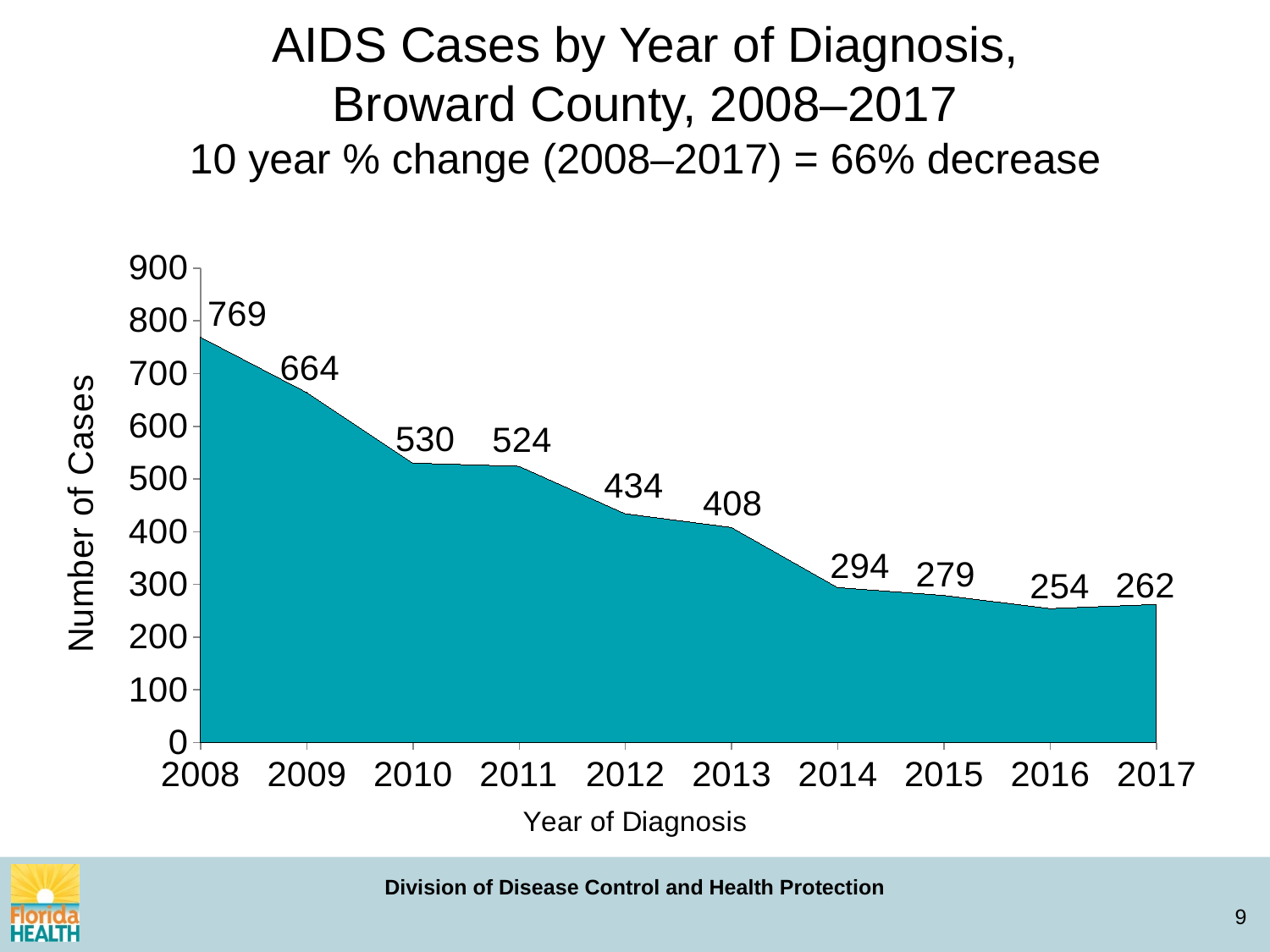
How many years are plotted on the chart? 10 How many AIDS cases were diagnosed in Broward County in 2008? 769 Is the value for 2012 greater or less than 400? greater What is the difference in cases between 2010 and 2011? 6 Which year had more cases, 2014 or 2015? 2014 Which year has the lowest number of cases? 2016 Which year has the highest number of cases? 2008 What is the overall trend in the number of cases from 2008 to 2017? Decreasing What is the number of cases for 2013? 408 What kind of chart is shown on the slide? Area chart What is the difference in cases between 2008 and 2017? 507 What is the number of cases for 2017? 262